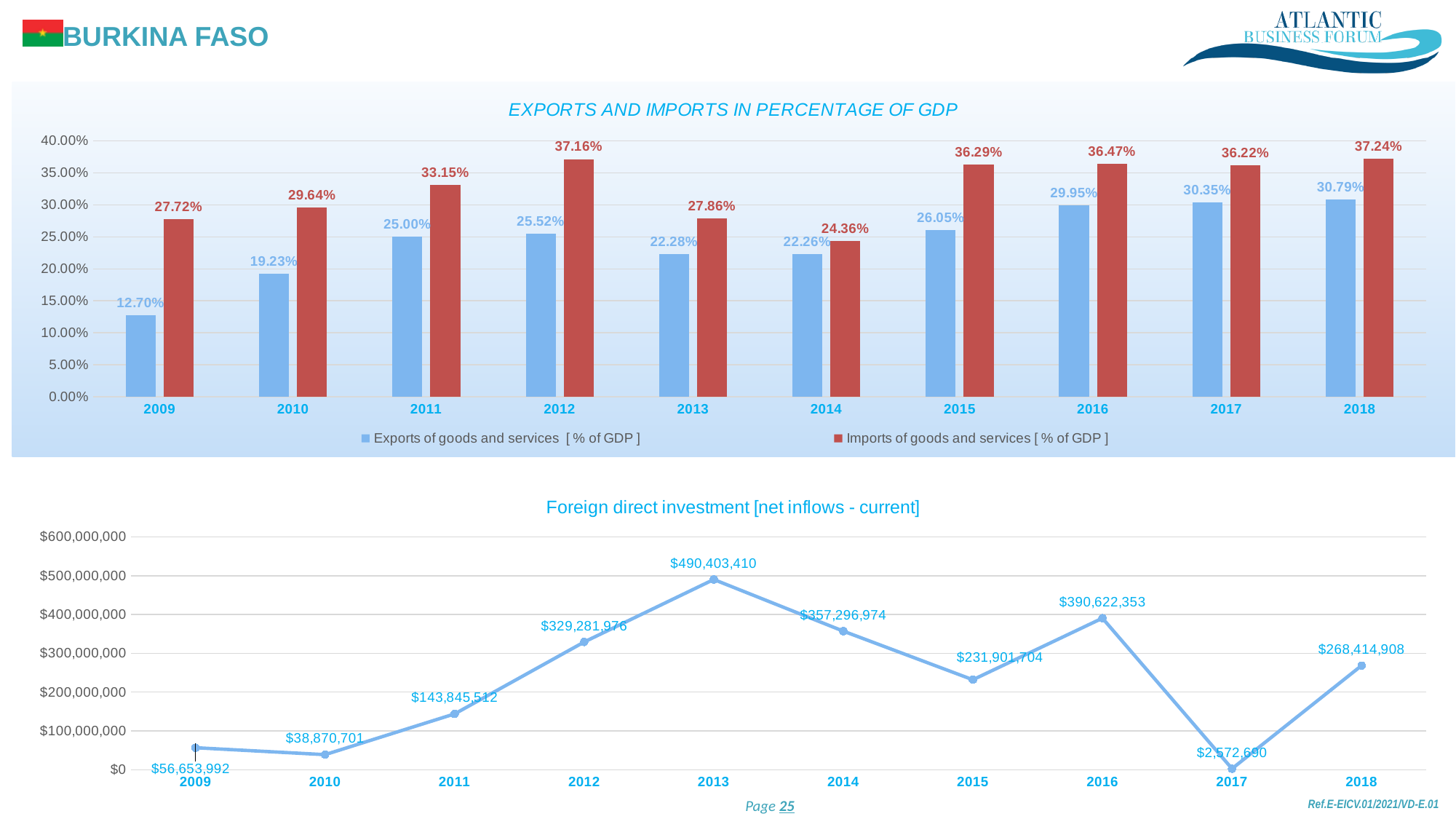
What kind of chart is the 'Foreign direct investment [net inflows - current]' chart? Line chart What kind of chart is the 'EXPORTS AND IMPORTS IN PERCENTAGE OF GDP' chart? Bar chart In the 'EXPORTS AND IMPORTS IN PERCENTAGE OF GDP' chart, which year has the highest imports value? 2018 In the 'Foreign direct investment [net inflows - current]' chart, what is the value for 2013? $490,403,410 In the 'EXPORTS AND IMPORTS IN PERCENTAGE OF GDP' chart, what is the value of imports of goods and services in 2012? 37.16% In the 'Foreign direct investment [net inflows - current]' chart, which year has the lowest value? 2017 In the 'EXPORTS AND IMPORTS IN PERCENTAGE OF GDP' chart, which year has the lowest exports value? 2009 In the 'EXPORTS AND IMPORTS IN PERCENTAGE OF GDP' chart, what is the difference between imports and exports in 2012? 11.64% In the 'Foreign direct investment [net inflows - current]' chart, how many years are plotted? 10 In the 'EXPORTS AND IMPORTS IN PERCENTAGE OF GDP' chart, how many series does the legend list? 2 In the 'EXPORTS AND IMPORTS IN PERCENTAGE OF GDP' chart, what is the value of exports of goods and services in 2009? 12.70% In the 'Foreign direct investment [net inflows - current]' chart, what is the difference between the 2013 and 2014 values? $133,106,436